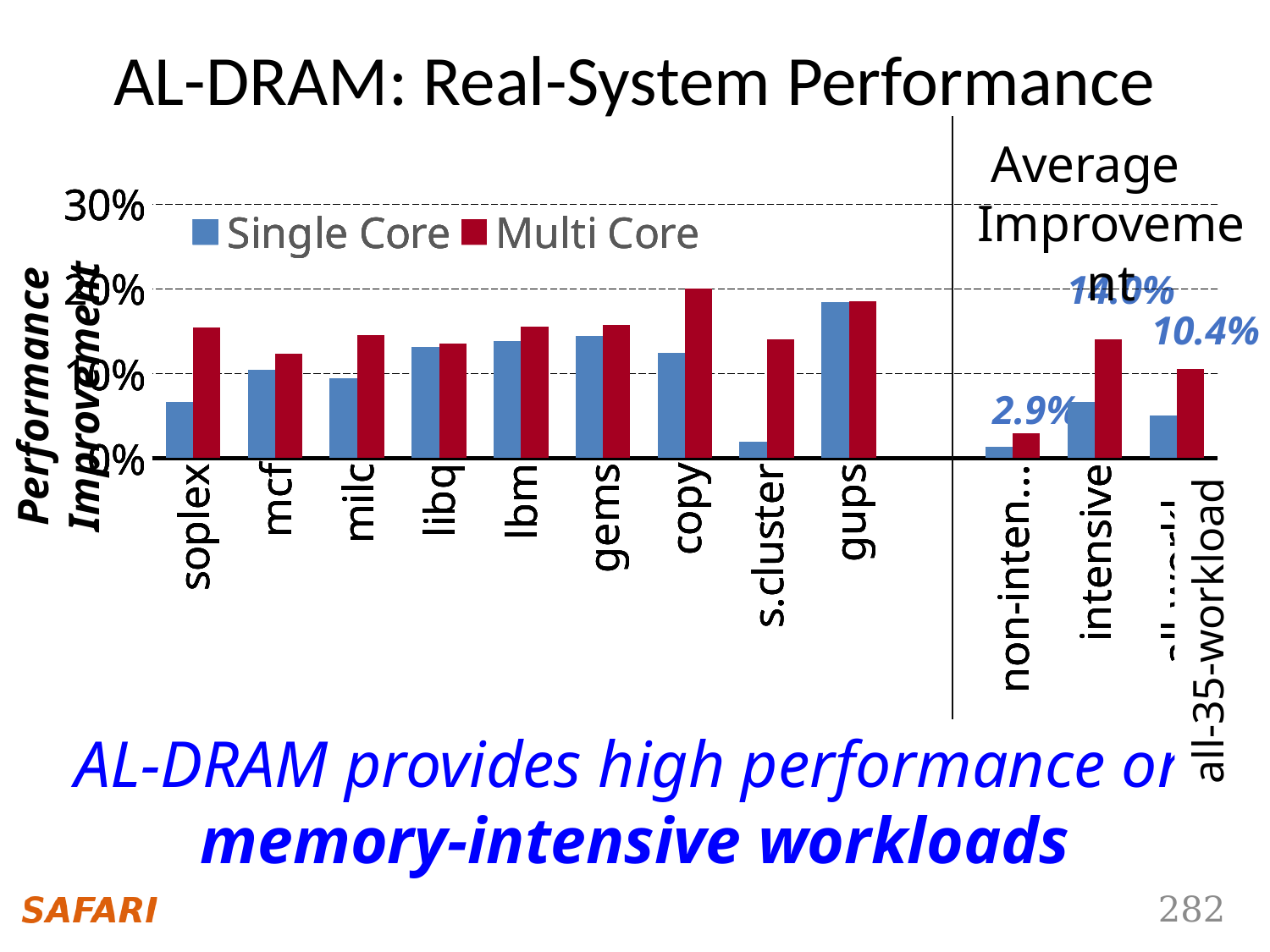
How many series does the legend list? 2 What are the two series named in the legend? Single Core and Multi Core Which workload has the highest Multi Core performance improvement? copy Is the Single Core value for s.cluster greater or less than 10%? less What is the title of the slide containing the chart? AL-DRAM: Real-System Performance What kind of chart is shown on the slide? bar chart For soplex, which is larger: the Single Core or the Multi Core performance improvement? Multi Core How many individual workloads are plotted to the left of the vertical divider line? 9 Which of the nine individual workloads has the lowest Single Core performance improvement? s.cluster Is the Multi Core value for copy greater or less than 10%? greater Which workload has the highest Single Core performance improvement? gups Is the Single Core value for gups greater or less than 10%? greater